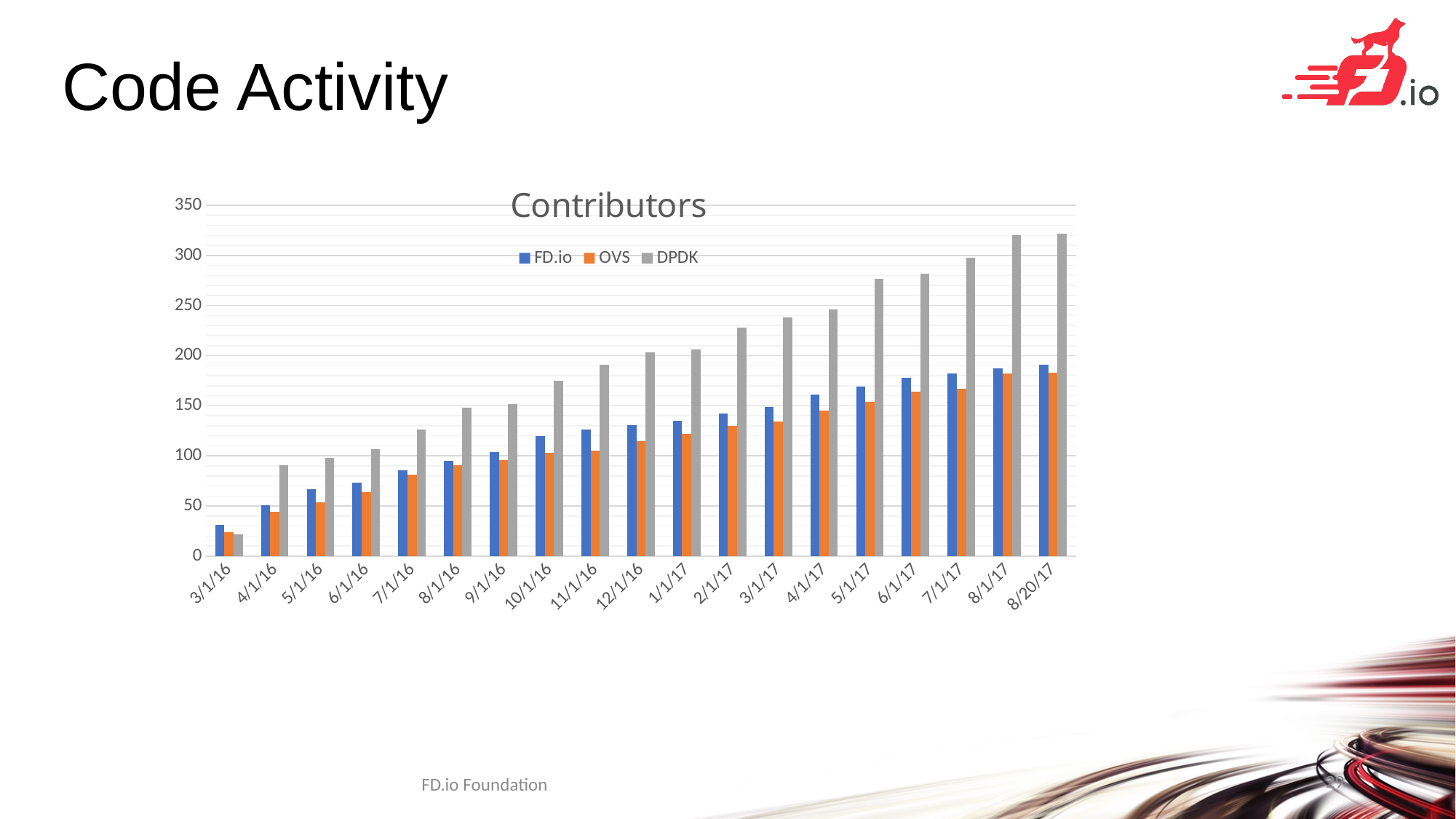
How many dates are shown along the x axis of the chart? 19 Do the DPDK values rise or fall from 3/1/16 to 8/20/17? rise On which date is the DPDK value lowest? 3/1/16 What is the title of the chart? Contributors How many series does the chart's legend list? 3 Is the DPDK value for 4/1/16 greater or less than 100? less For 12/1/16, which series has the larger value, DPDK or FD.io? DPDK Is the OVS value for 12/1/16 greater or less than 100? greater Is the FD.io value for 3/1/16 greater or less than 50? less What kind of chart is shown on the slide? bar chart